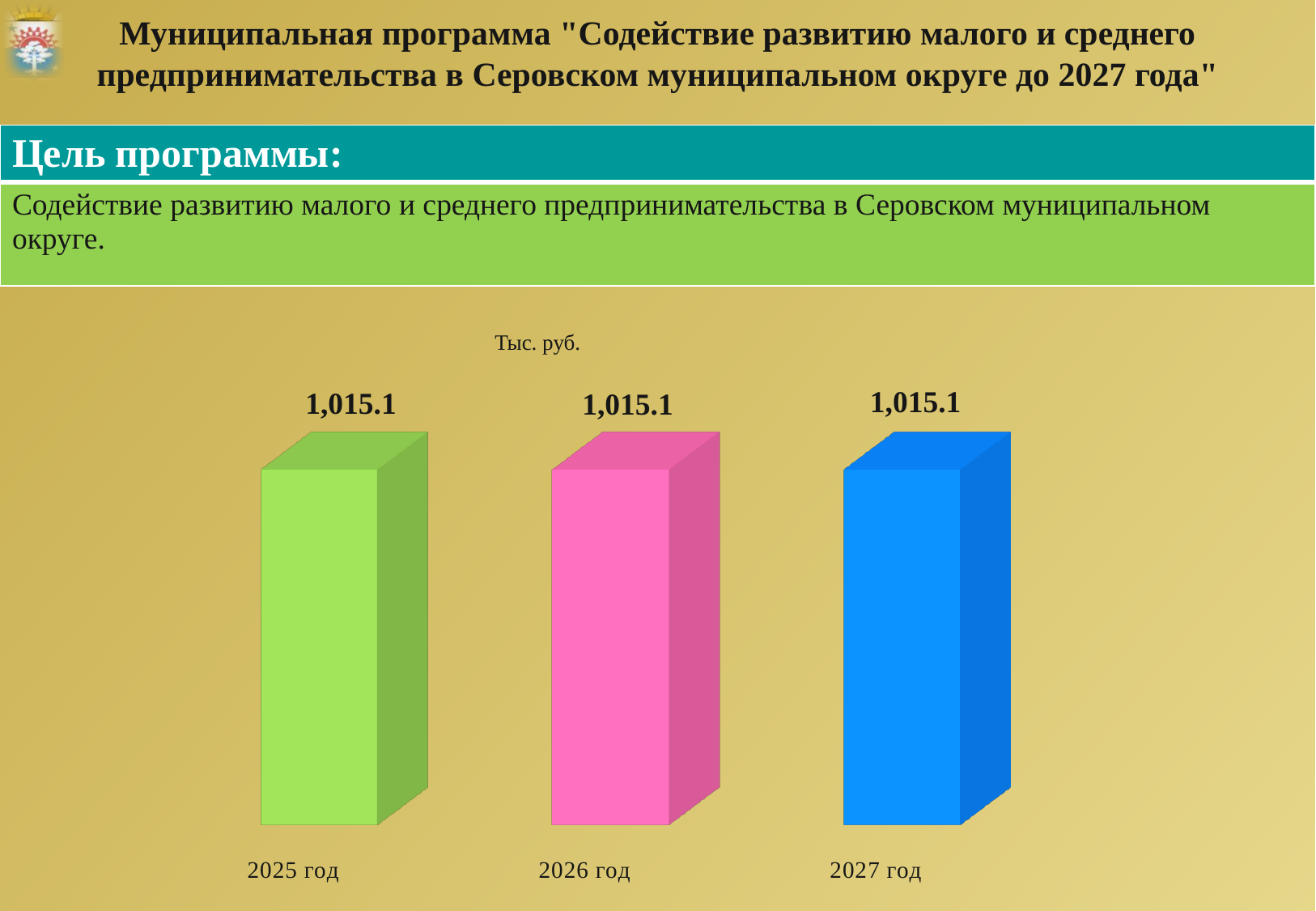
Do the values rise, fall or stay the same from 2025 год to 2027 год? stay the same What is the difference between the values for 2025 год and 2027 год? 0 How many categories are shown on the chart? 3 What unit is shown above the chart? Тыс. руб. What is the value for 2025 год? 1,015.1 What is the total of the values for 2025 год, 2026 год and 2027 год? 3,045.3 What kind of chart is shown on the slide? bar chart What colour is the bar for 2026 год? pink What is the value for 2027 год? 1,015.1 What is the value for 2026 год? 1,015.1